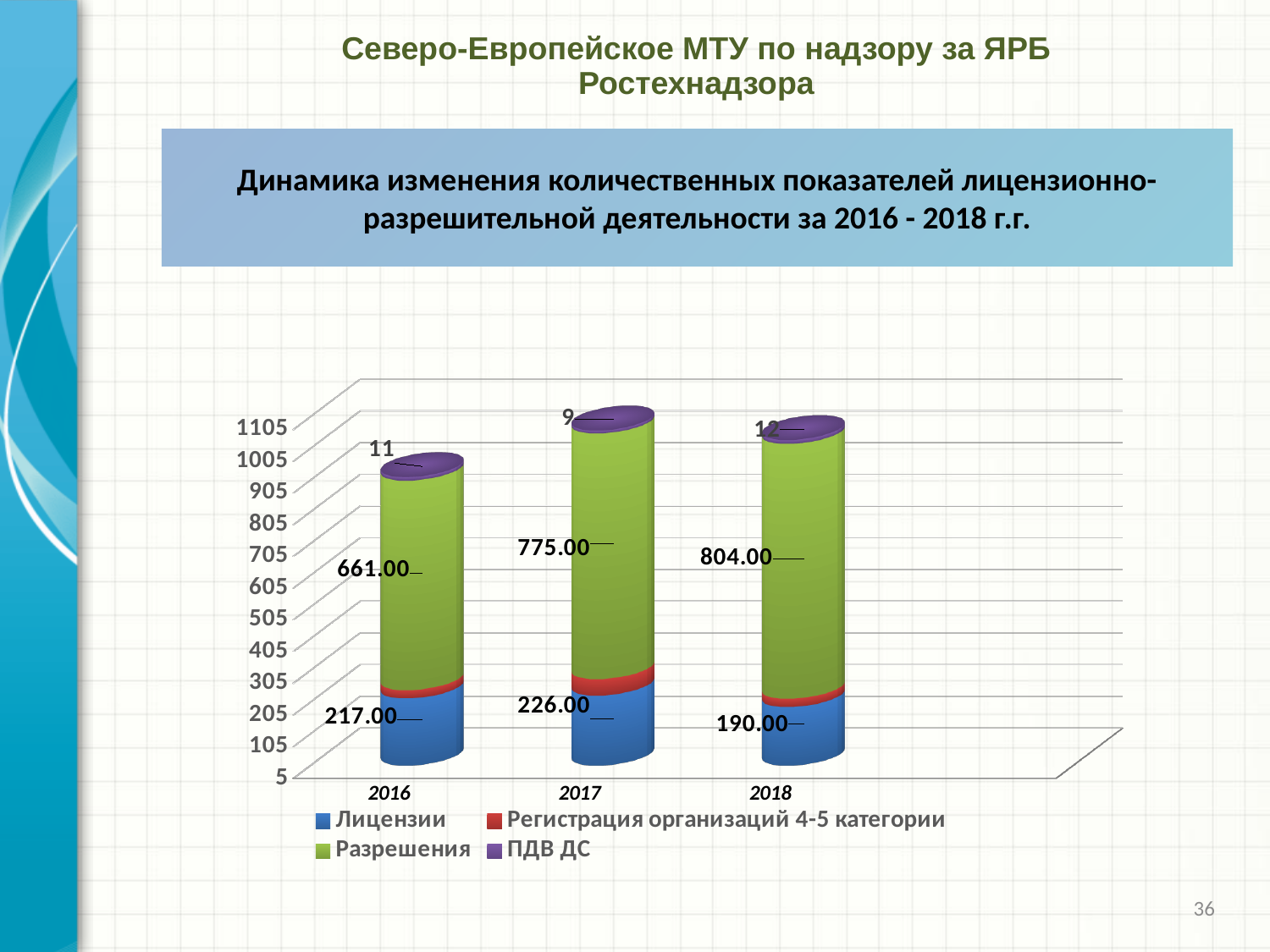
Which colour represents the Регистрация организаций 4-5 категории series? red In which year is the value of Разрешения highest? 2018 What is the value of ПДВ ДС for 2018? 12 How many series does the legend list? 4 In which year is the value of Лицензии lowest? 2018 Do the Разрешения values rise or fall from 2016 to 2018? rise What type of chart is shown on the slide? stacked bar chart What is the value of Разрешения for 2017? 775.00 How many years are shown on the x axis? 3 What is the difference between the Разрешения values for 2018 and 2016? 143.00 Which is larger, the Лицензии value for 2017 or for 2016? 2017 What is the value of Лицензии for 2016? 217.00